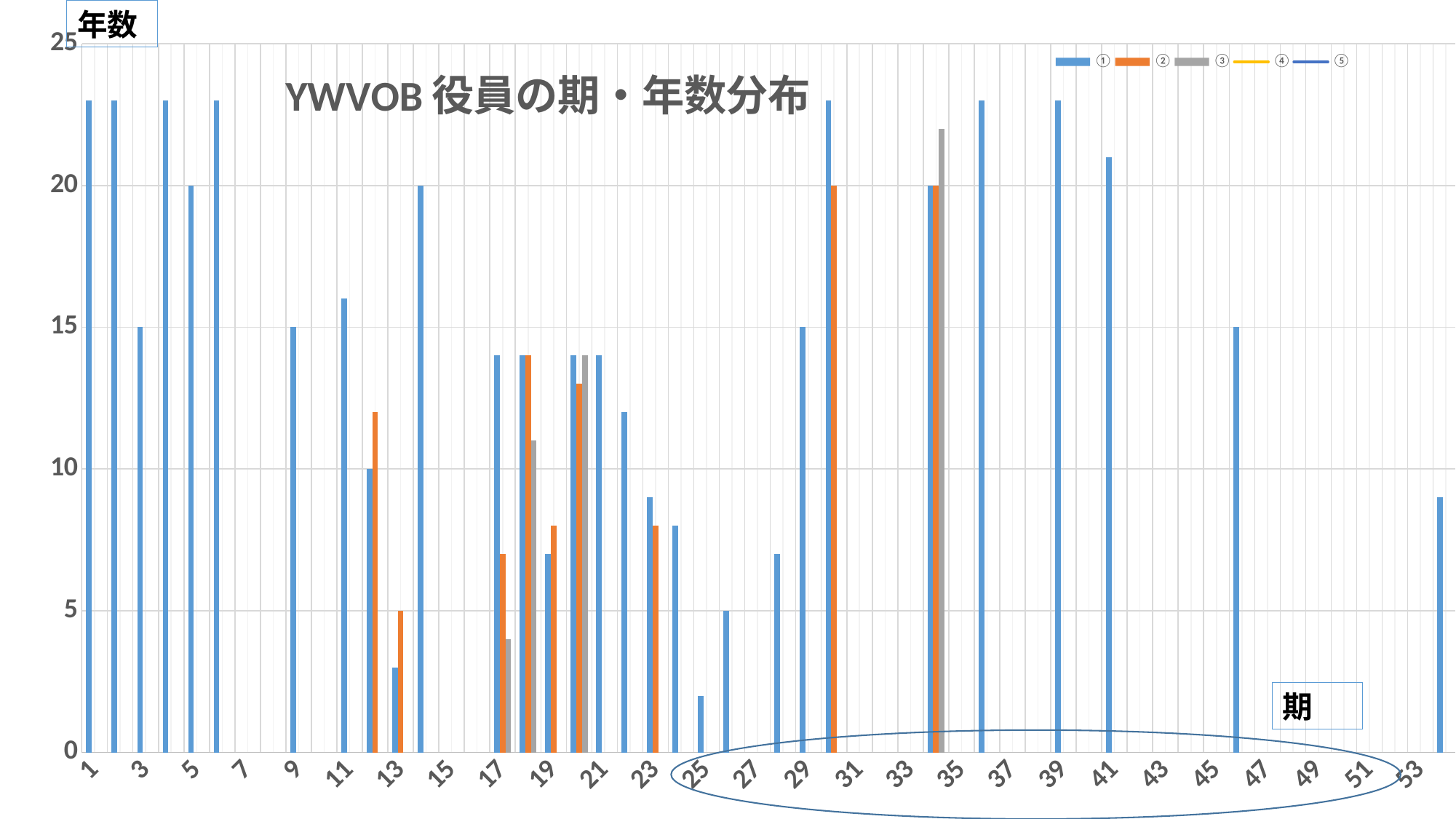
What label is shown on the vertical axis of the chart? 年数 What is the title of the chart? YWVOB 役員の期・年数分布 Is the value of series ① at 期 25 greater or less than 5? less Is the value of series ② at 期 30 greater or less than 15? greater For series ①, which is larger: the value at 期 2 or the value at 期 3? 期 2 How many series does the legend list? 5 Is the value of series ① at 期 1 greater or less than 20? greater What kind of chart is shown on the slide? bar chart For series ②, which is larger: the value at 期 12 or the value at 期 13? 期 12 For series ①, which is larger: the value at 期 41 or the value at 期 46? 期 41